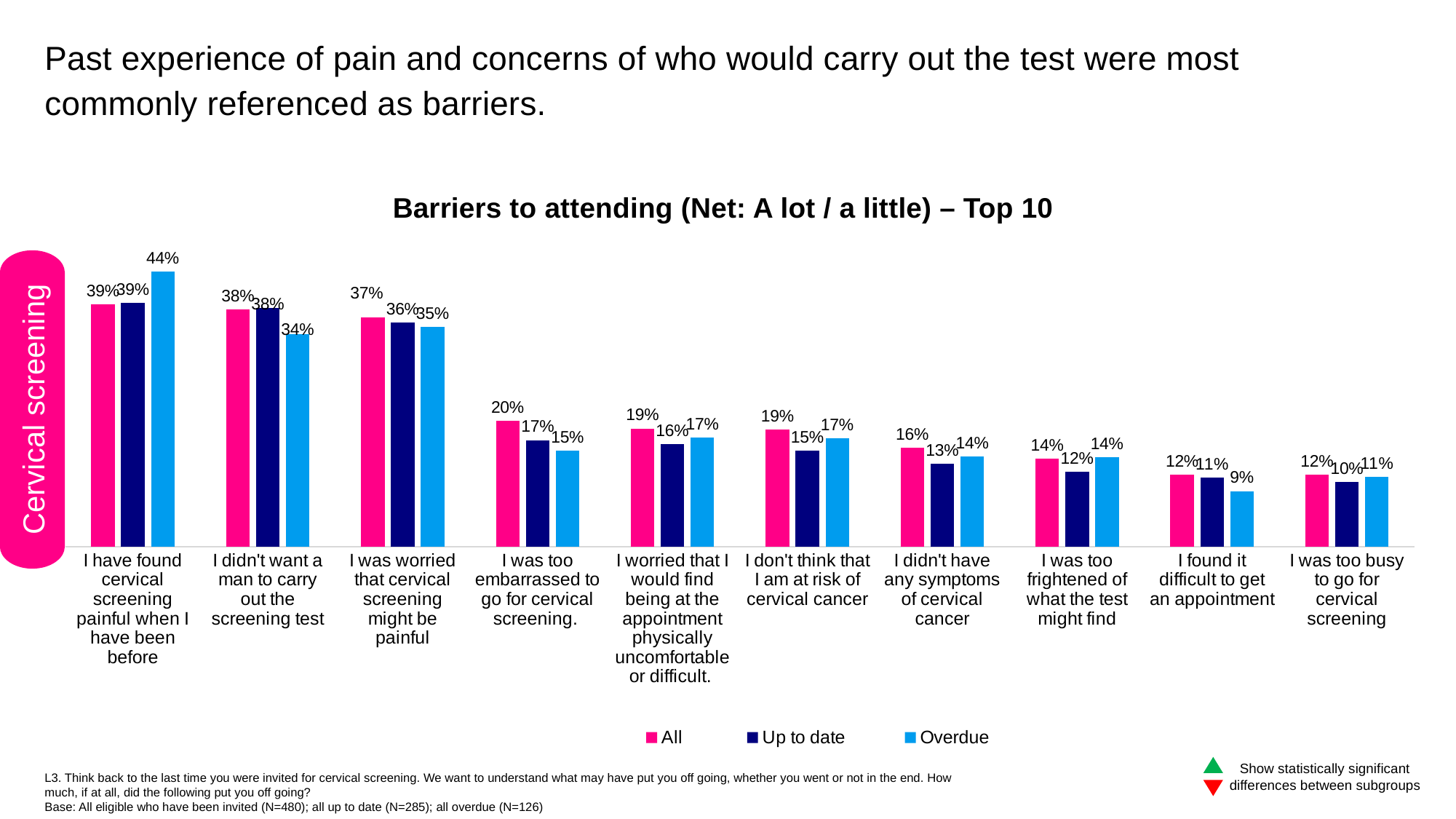
What is the All value for 'I was too embarrassed to go for cervical screening.'? 20% What is the title of the chart? Barriers to attending (Net: A lot / a little) – Top 10 What is the Overdue value for 'I found it difficult to get an appointment'? 9% Which is larger for 'I didn't want a man to carry out the screening test': the All value or the Overdue value? All Which category has the lowest Overdue value? I found it difficult to get an appointment How many series does the legend list? 3 Which category has the highest Overdue value? I have found cervical screening painful when I have been before What is the Up to date value for 'I was worried that cervical screening might be painful'? 36% What kind of chart is shown on the slide? Bar chart What is the difference between the Overdue and Up to date values for 'I have found cervical screening painful when I have been before'? 5% What is the Overdue value for 'I have found cervical screening painful when I have been before'? 44% How many categories are shown on the x axis? 10